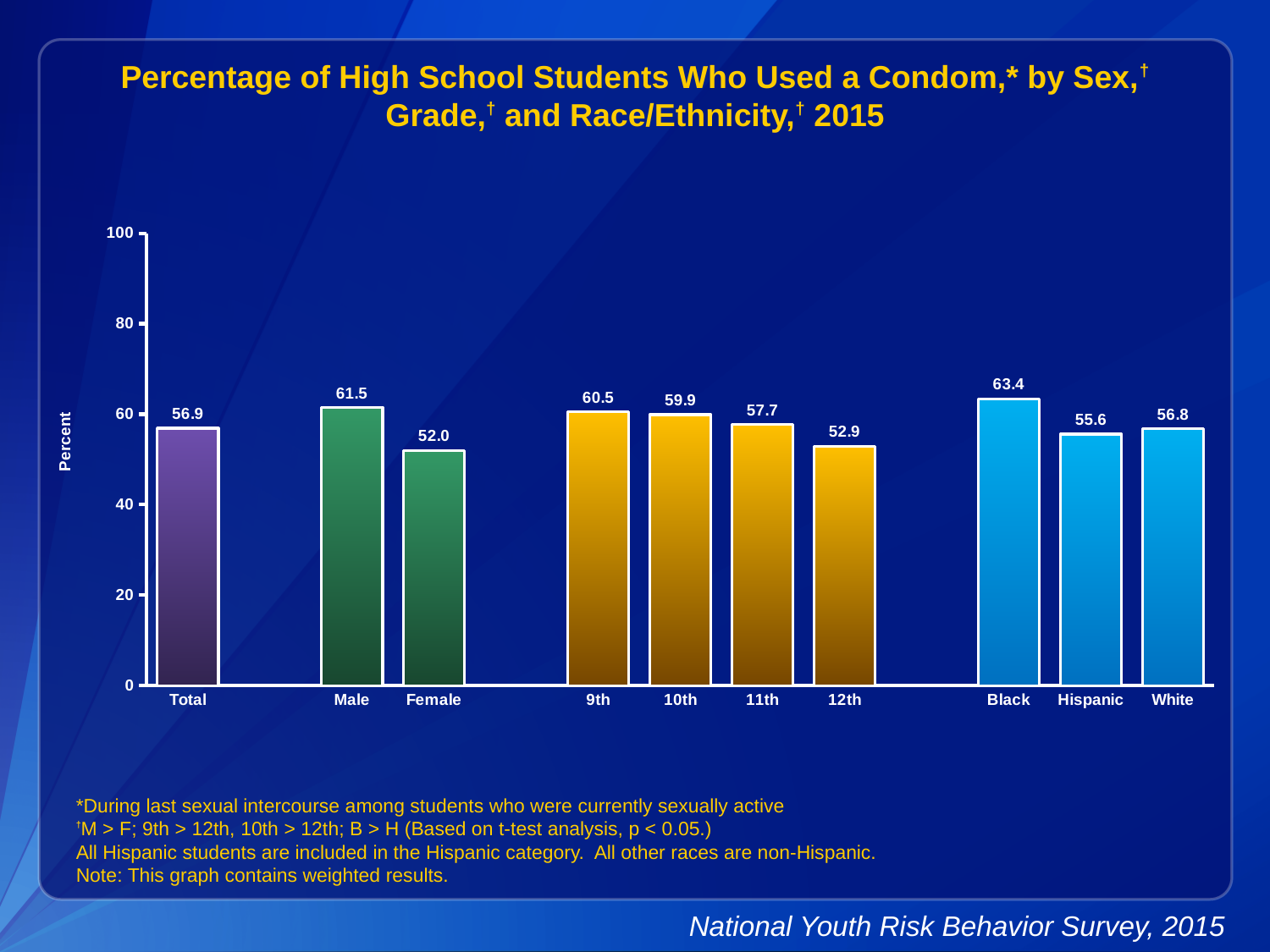
Which category has the highest value? Black Which is larger, the value for Black or the value for White? Black What is the value for 11th grade? 57.7 What is the value for Hispanic students? 55.6 What kind of chart is shown on the slide? Bar chart How many bars are shown in the chart? 10 What is the value for Female? 52.0 What is the difference between the Male and Female values? 9.5 Which category has the lowest value? Female What is the value for Total? 56.9 What is the difference between the 9th grade and 12th grade values? 7.6 What is the label on the y axis? Percent